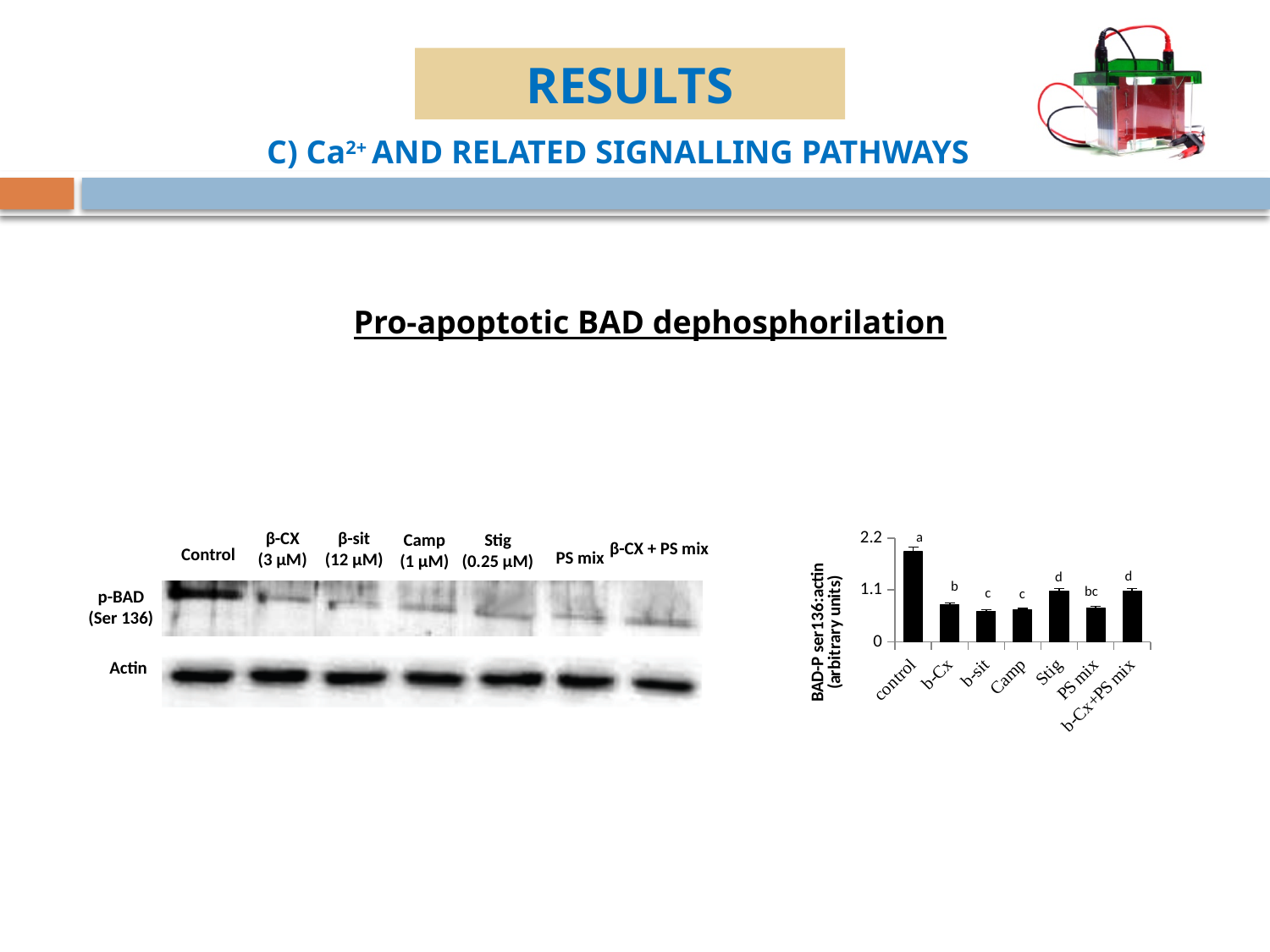
Is the value for control greater or less than 1.1? greater Is the value for b-sit greater or less than 1.1? less Is the value for PS mix greater or less than 1.1? less Which is larger in the bar chart, the value for control or the value for Stig? control What is the highest tick value shown on the y axis of the bar chart? 2.2 Which category has the highest BAD-P ser136:actin value in the bar chart? control What is the label of the y axis of the bar chart? BAD-P ser136:actin (arbitrary units) What kind of chart is shown on the right of the slide? bar chart Which is larger in the bar chart, the value for Stig or the value for b-sit? Stig Which is larger in the bar chart, the value for control or the value for b-Cx? control How many categories are plotted on the x axis of the bar chart? 7